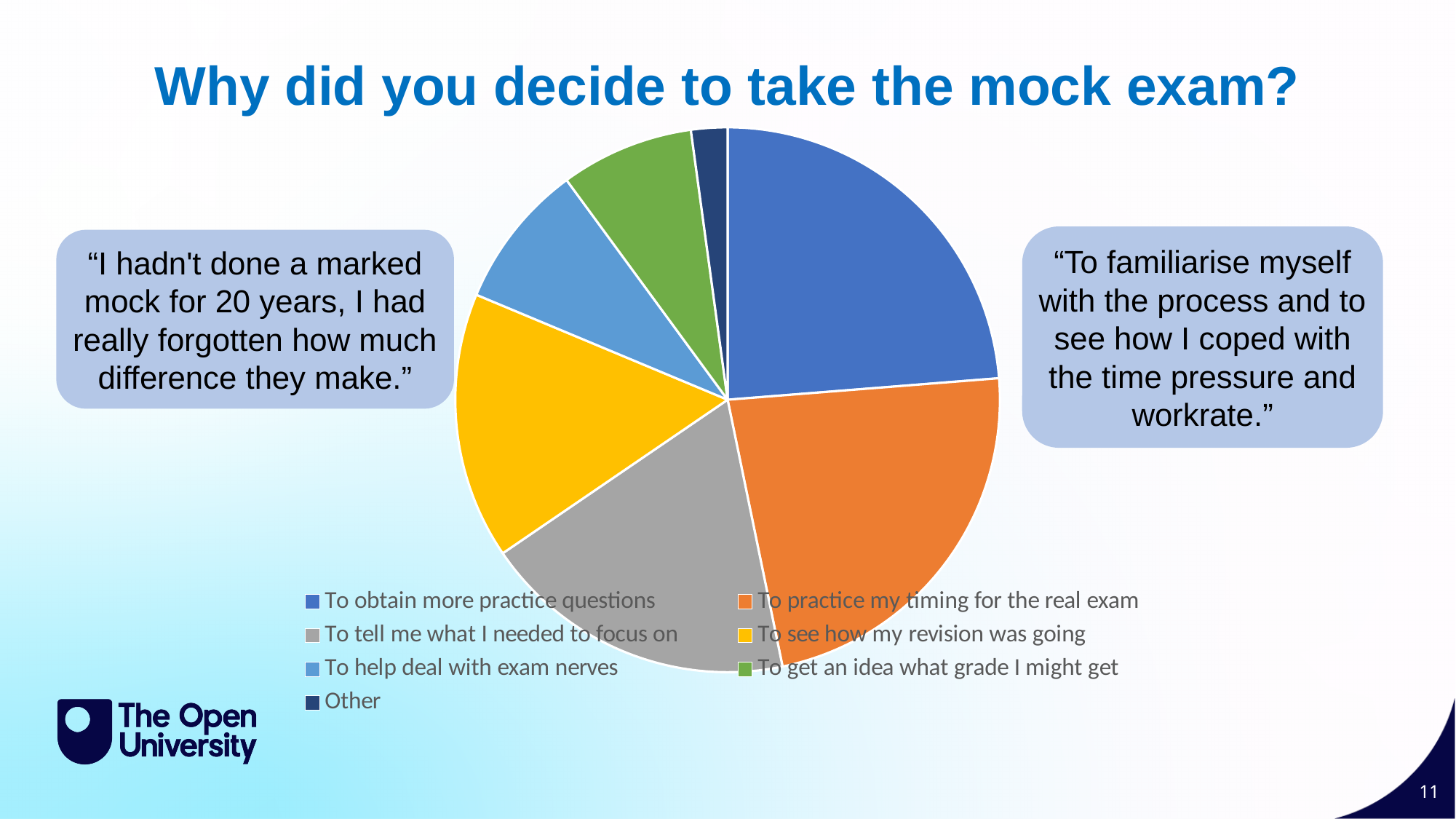
Which slice is larger: "To see how my revision was going" or "To get an idea what grade I might get"? To see how my revision was going How many entries does the chart legend list? 7 What is the title of the slide containing the pie chart? Why did you decide to take the mock exam? Which slice is larger: "To help deal with exam nerves" or "Other"? To help deal with exam nerves Which slice is larger: "To practice my timing for the real exam" or "To tell me what I needed to focus on"? To practice my timing for the real exam Which category has the smallest slice of the pie chart? Other How many categories (slices) does the pie chart have? 7 What kind of chart is shown on the slide? pie chart What colour is the slice for "To see how my revision was going"? yellow